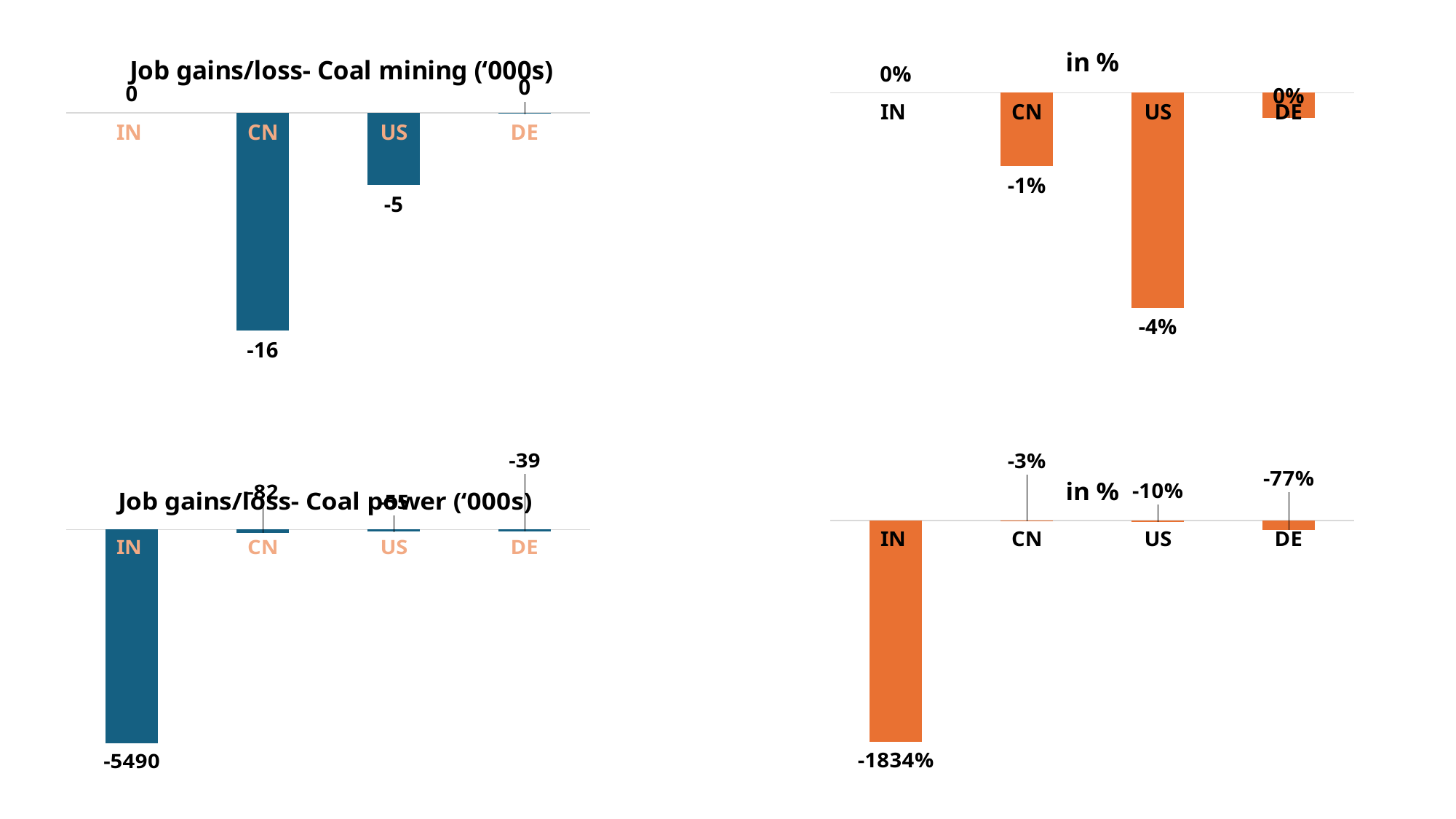
In the top-right 'in %' chart, what is the value for US? -4% In the 'Job gains/loss- Coal power ('000s)' chart, what is the value for IN? -5490 How many countries are shown in the 'Job gains/loss- Coal mining ('000s)' chart? 4 In the top-right 'in %' chart, what is the value for CN? -1% In the bottom-right 'in %' chart, what is the value for IN? -1834% In the 'Job gains/loss- Coal mining ('000s)' chart, what is the value for CN? -16 In the bottom-right 'in %' chart, which country has the lowest value? IN In the 'Job gains/loss- Coal power ('000s)' chart, what is the value for DE? -39 In the 'Job gains/loss- Coal mining ('000s)' chart, which country has the lowest value? CN In the 'Job gains/loss- Coal mining ('000s)' chart, what is the value for US? -5 In the 'Job gains/loss- Coal mining ('000s)' chart, what is the difference between the values for CN and US? 11 In the bottom-right 'in %' chart, what is the value for DE? -77%